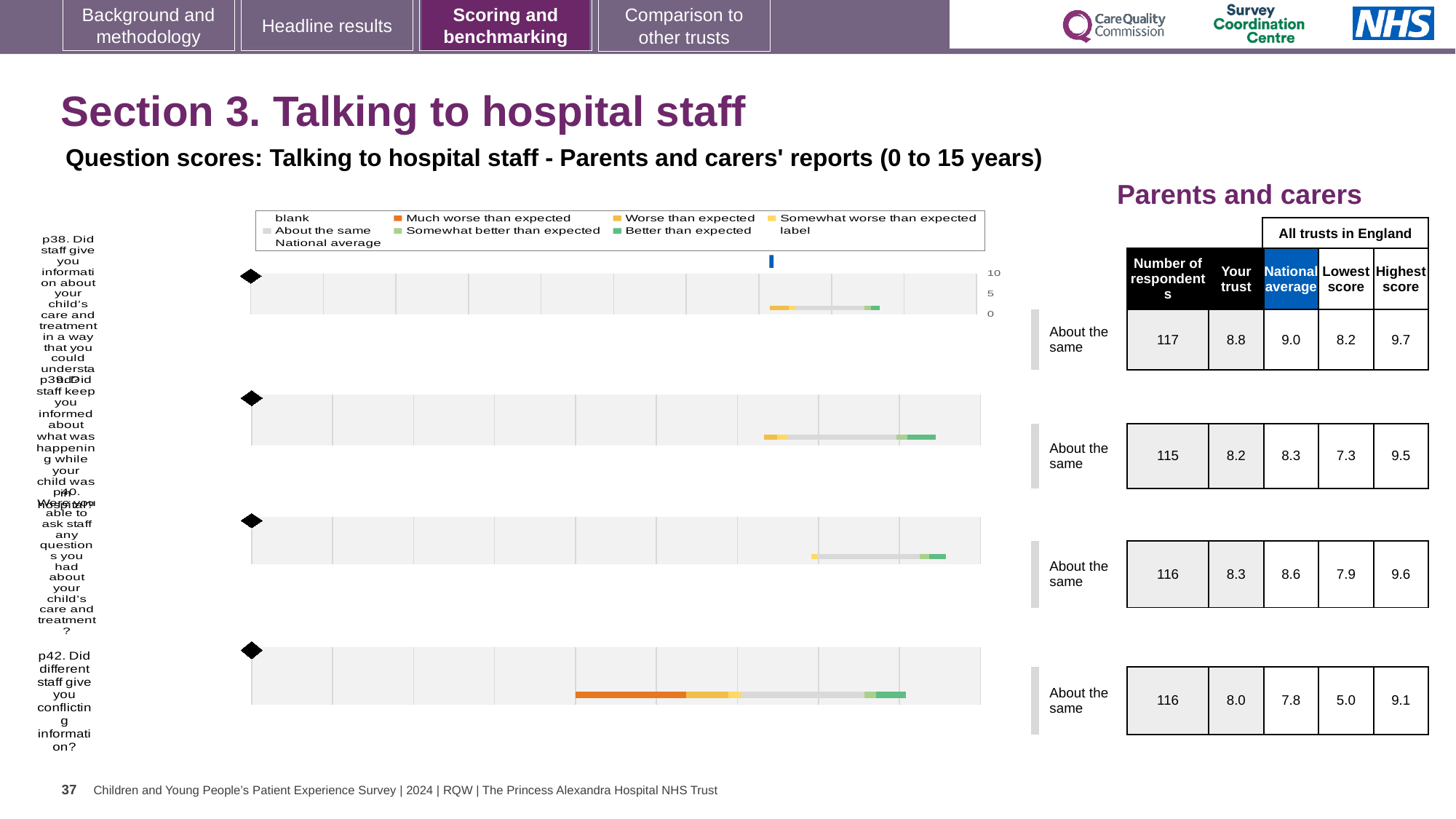
What colour does the legend use for 'Much worse than expected'? orange What is the national average score shown for question p42 (Did different staff give you conflicting information)? 7.8 Which question has the lowest 'Your trust' score on this slide? p42 For question p40, which is larger: the 'Your trust' score or the national average? National average How many survey questions (p38, p39, p40, p42) are plotted as bars on this slide? 4 What benchmark category is shown next to each of the four question bars on this slide? About the same What kind of chart is used to show the question scores on this slide? bar chart What is the 'Your trust' score shown for question p38 (Did staff give you information about your child's care and treatment in a way that you could understand)? 8.8 What is the difference between the highest score (9.7) and the lowest score (8.2) for question p38? 1.5 Which question has the highest 'Your trust' score on this slide? p38 What is the lowest score across all trusts in England for question p42? 5.0 How many respondents are shown for question p39 (Did staff keep you informed about what was happening while your child was in hospital)? 115